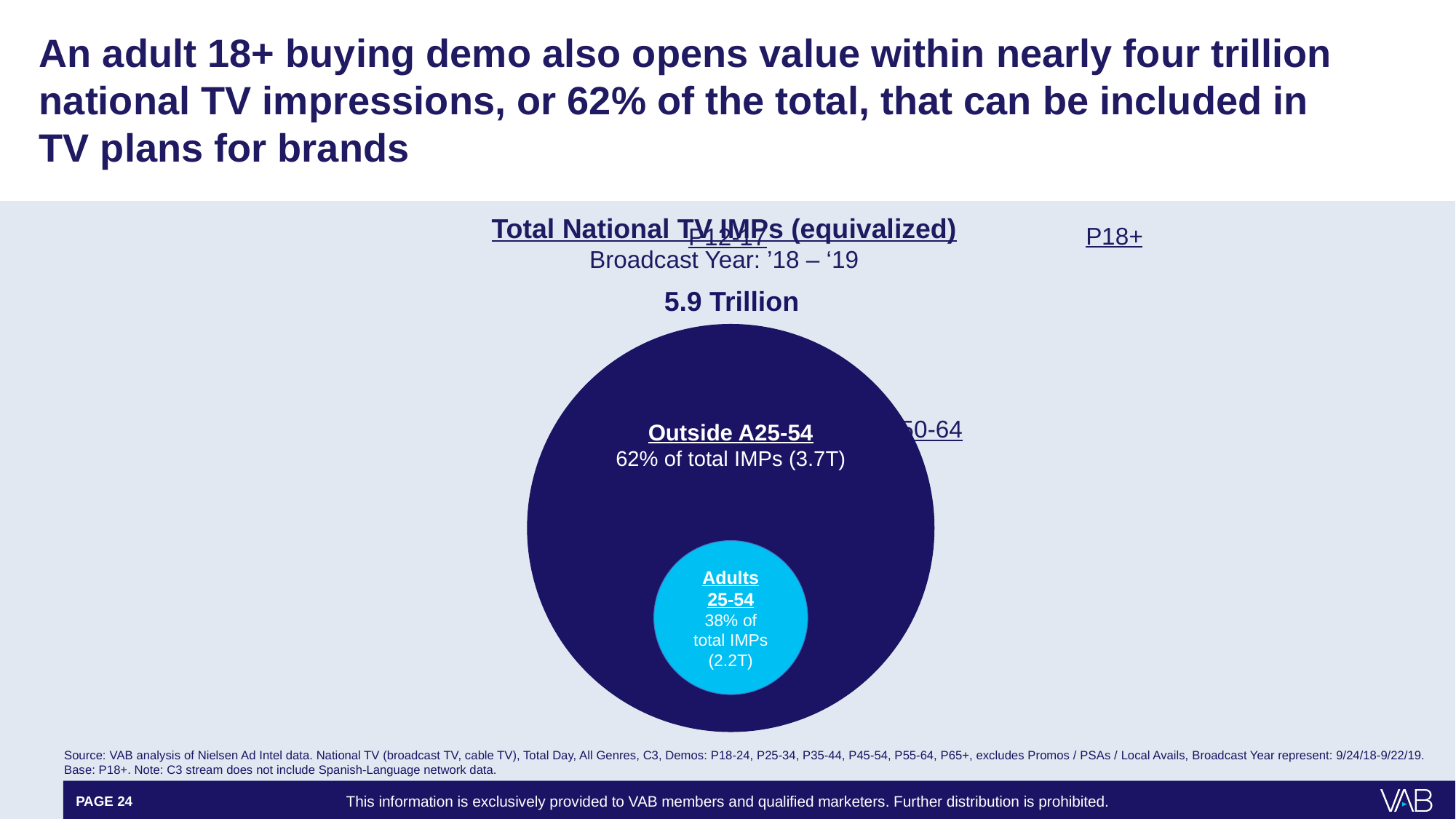
Which segment has the larger share of total IMPs, Adults 25-54 or Outside A25-54? Outside A25-54 What is the difference in trillions of impressions between the Outside A25-54 segment and the Adults 25-54 segment? 1.5T How many trillion impressions are attributed to the Adults 25-54 segment? 2.2T How many audience segments are shown in the circle diagram? 2 Which segment has the smallest share of total IMPs? Adults 25-54 By how many percentage points does the Outside A25-54 share exceed the Adults 25-54 share? 24 percentage points What is the total national TV impressions figure shown above the circle diagram? 5.9 Trillion What share of total IMPs does the Outside A25-54 segment represent? 62% How many trillion impressions are attributed to the Outside A25-54 segment? 3.7T What broadcast year does the chart title say the data covers? '18 – '19 What kind of chart is used to show the impressions breakdown? Nested circle diagram What share of total IMPs does the Adults 25-54 segment represent? 38%